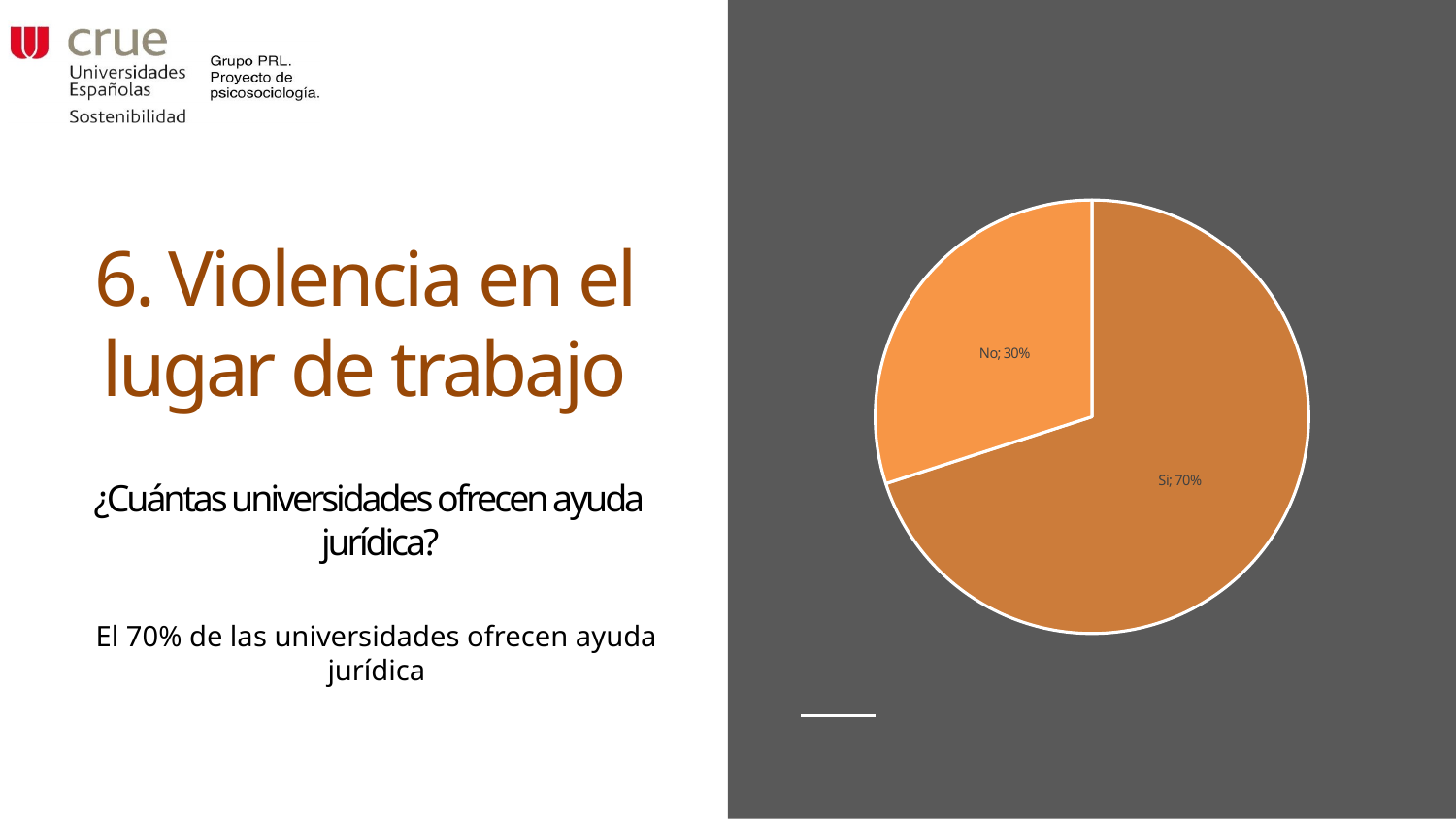
What kind of chart is shown on the slide? pie chart Which slice of the pie chart is the largest? Si What share of the pie does the "No" slice represent? 30% How many slices does the pie chart have? 2 What is the value for the "Si" slice of the pie chart? 70% What question does the slide say the pie chart answers? ¿Cuántas universidades ofrecen ayuda jurídica? Which is larger in the pie chart, "Si" or "No"? Si Which slice of the pie chart is shown in the lighter orange colour? No What share of the pie does the "Si" slice represent? 70% What is the value for the "No" slice of the pie chart? 30% Which slice of the pie chart is the smallest? No What is the difference between the "Si" and "No" slices of the pie chart? 40%